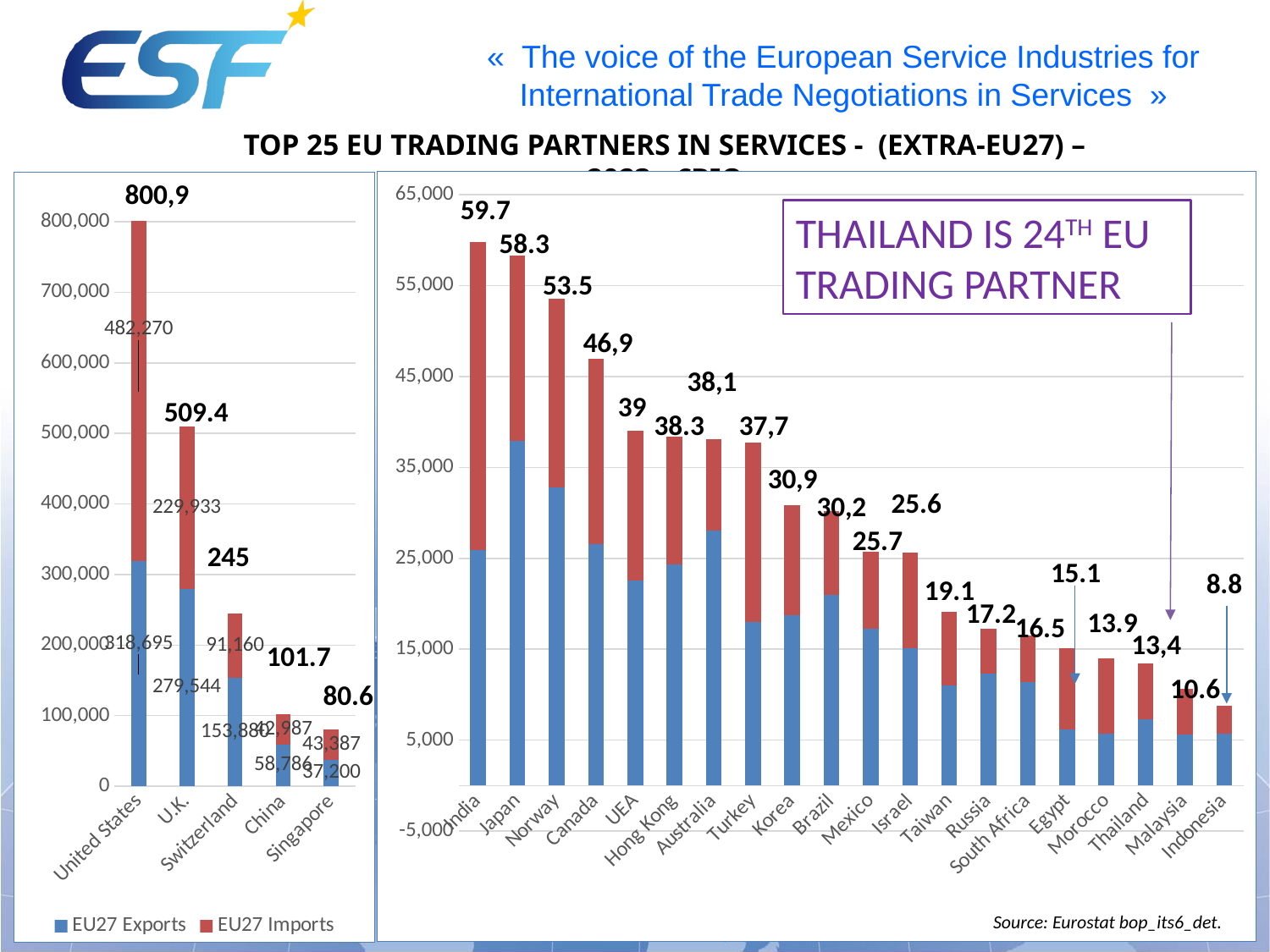
In the left chart, what is the EU27 Exports value for the United States? 318,695 What kind of chart is the right chart? Stacked bar chart In the left chart, what is the total value labelled above the United States bar? 800,9 In the right chart, how many countries are shown on the x axis? 20 In the right chart, what is the value labelled above the Thailand bar? 13,4 In the right chart, do the totals rise or fall from India to Indonesia along the x axis? Fall In the right chart, which has the larger total, Norway or Canada? Norway In the right chart, what is the difference between the labelled totals for India and Japan? 1.4 How many series does the legend of the left chart list? 2 In the right chart, which country has the lowest total? Indonesia In the left chart, how many countries are shown on the x axis? 5 In the right chart, what is the value labelled above the India bar? 59.7